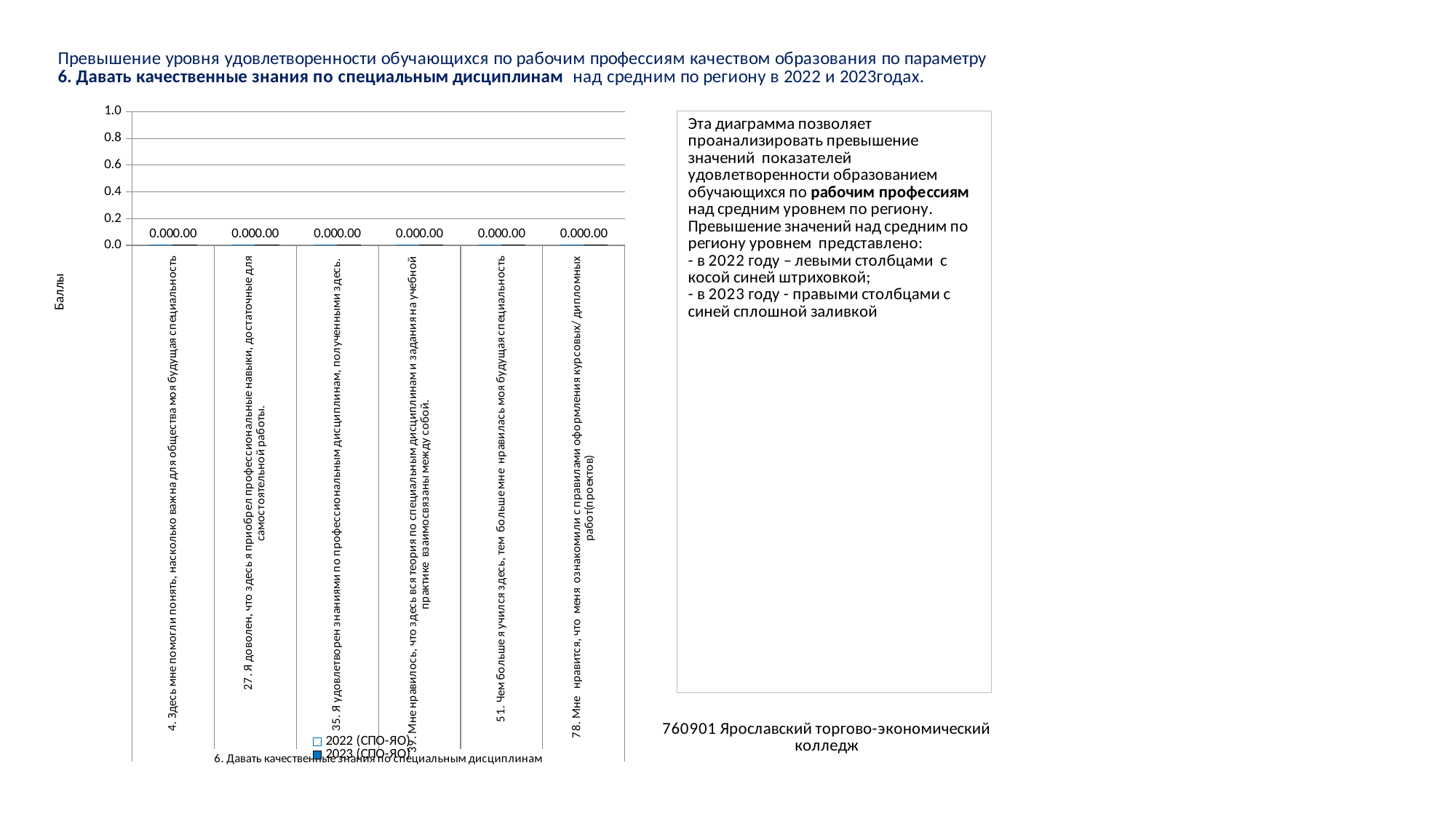
Is the value for category "51. Чем больше я учился здесь, тем больше мне нравилась моя будущая специальность" greater or less than 0.4? less Is the value for category "35. Я удовлетворен знаниями по профессиональным дисциплинам, полученными здесь." greater or less than 0.6? less What is the title of the vertical axis of the chart? Баллы Is the value for category "78. Мне нравится, что меня ознакомили с правилами оформления курсовых/ дипломных работ(проектов)" greater or less than 0.2? less What kind of chart is shown on the slide? bar chart What is the highest tick value shown on the vertical axis of the chart? 1.0 What are the two series named in the chart legend? 2022 (СПО-ЯО) and 2023 (СПО-ЯО) How many series does the chart legend list? 2 How many categories (questions) are shown along the x axis of the chart? 6